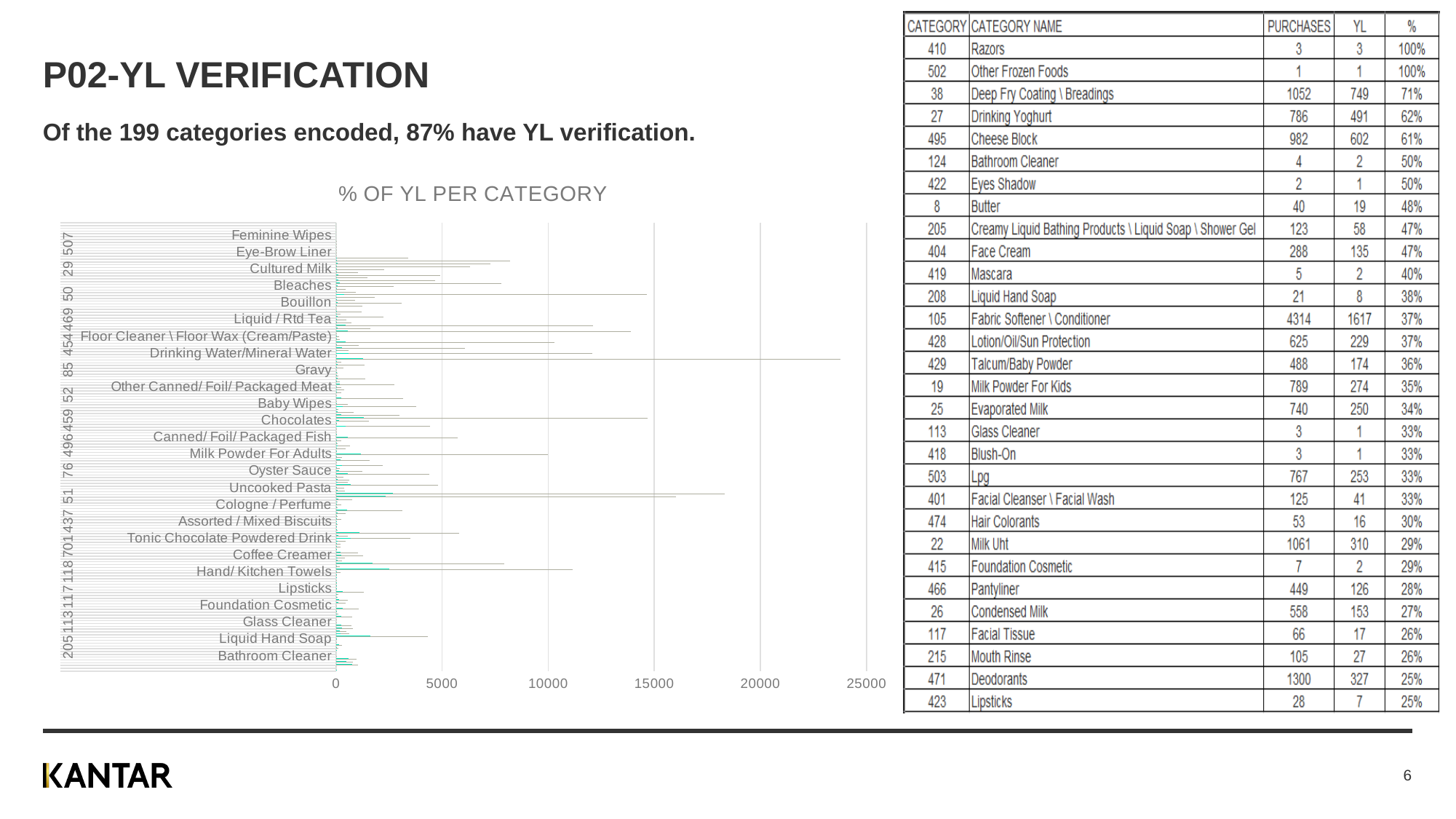
Is the longest bar in the chart greater or less than 20000? greater Are the bars in the chart drawn horizontally or vertically? horizontally Is the longest bar in the chart greater or less than 25000? less Is the bar for Bathroom Cleaner greater or less than 5000? less What is the highest value shown on the x axis of the chart? 25000 What kind of chart is shown on the slide? bar chart What is the title of the chart on the slide? % OF YL PER CATEGORY